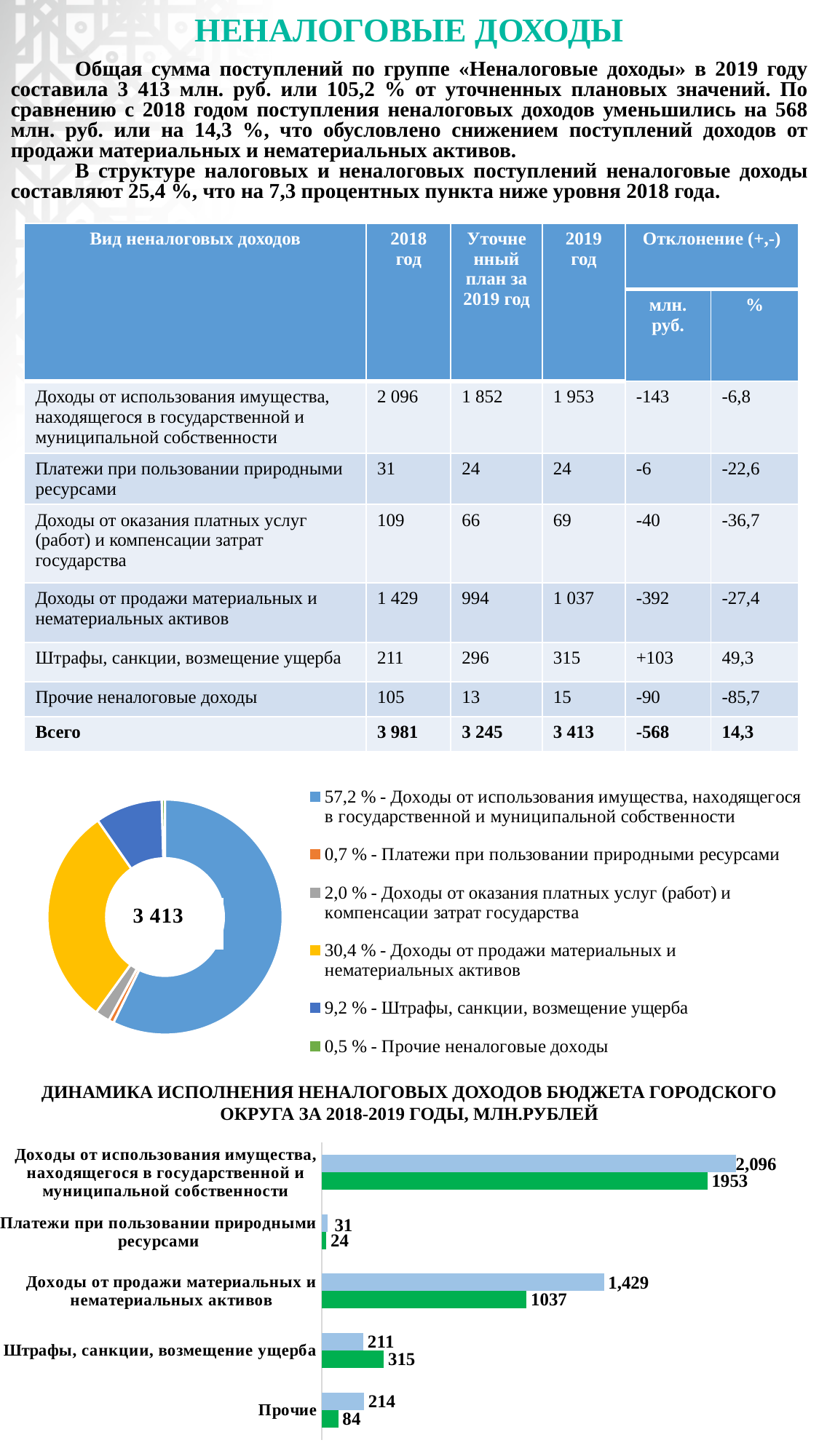
In the bar chart «ДИНАМИКА ИСПОЛНЕНИЯ НЕНАЛОГОВЫХ ДОХОДОВ...», for «Штрафы, санкции, возмещение ущерба», which bar is larger: the light blue bar or the green bar? the green bar (315) What kind of chart is the chart at the bottom of the slide titled «ДИНАМИКА ИСПОЛНЕНИЯ НЕНАЛОГОВЫХ ДОХОДОВ БЮДЖЕТА ГОРОДСКОГО ОКРУГА ЗА 2018-2019 ГОДЫ, МЛН.РУБЛЕЙ»? bar chart What kind of chart is the chart in the middle of the slide with «3 413» in its centre? pie chart (donut) In the pie chart with «3 413» in its centre, which category has the largest share? Доходы от использования имущества, находящегося в государственной и муниципальной собственности In the pie chart with «3 413» in its centre, what share does «Доходы от продажи материальных и нематериальных активов» have? 30,4 % In the bar chart «ДИНАМИКА ИСПОЛНЕНИЯ НЕНАЛОГОВЫХ ДОХОДОВ...», what is the value of the light blue bar for «Доходы от продажи материальных и нематериальных активов»? 1,429 How many categories does the legend of the pie chart with «3 413» in its centre list? 6 In the bar chart «ДИНАМИКА ИСПОЛНЕНИЯ НЕНАЛОГОВЫХ ДОХОДОВ...», what is the difference between the light blue bar (214) and the green bar (84) for «Прочие»? 130 In the bar chart «ДИНАМИКА ИСПОЛНЕНИЯ НЕНАЛОГОВЫХ ДОХОДОВ...», what is the value of the green bar for «Штрафы, санкции, возмещение ущерба»? 315 How many categories are shown on the bar chart «ДИНАМИКА ИСПОЛНЕНИЯ НЕНАЛОГОВЫХ ДОХОДОВ...»? 5 In the pie chart with «3 413» in its centre, what share does «Штрафы, санкции, возмещение ущерба» have? 9,2 % In the pie chart with «3 413» in its centre, which category has the smallest share? Прочие неналоговые доходы